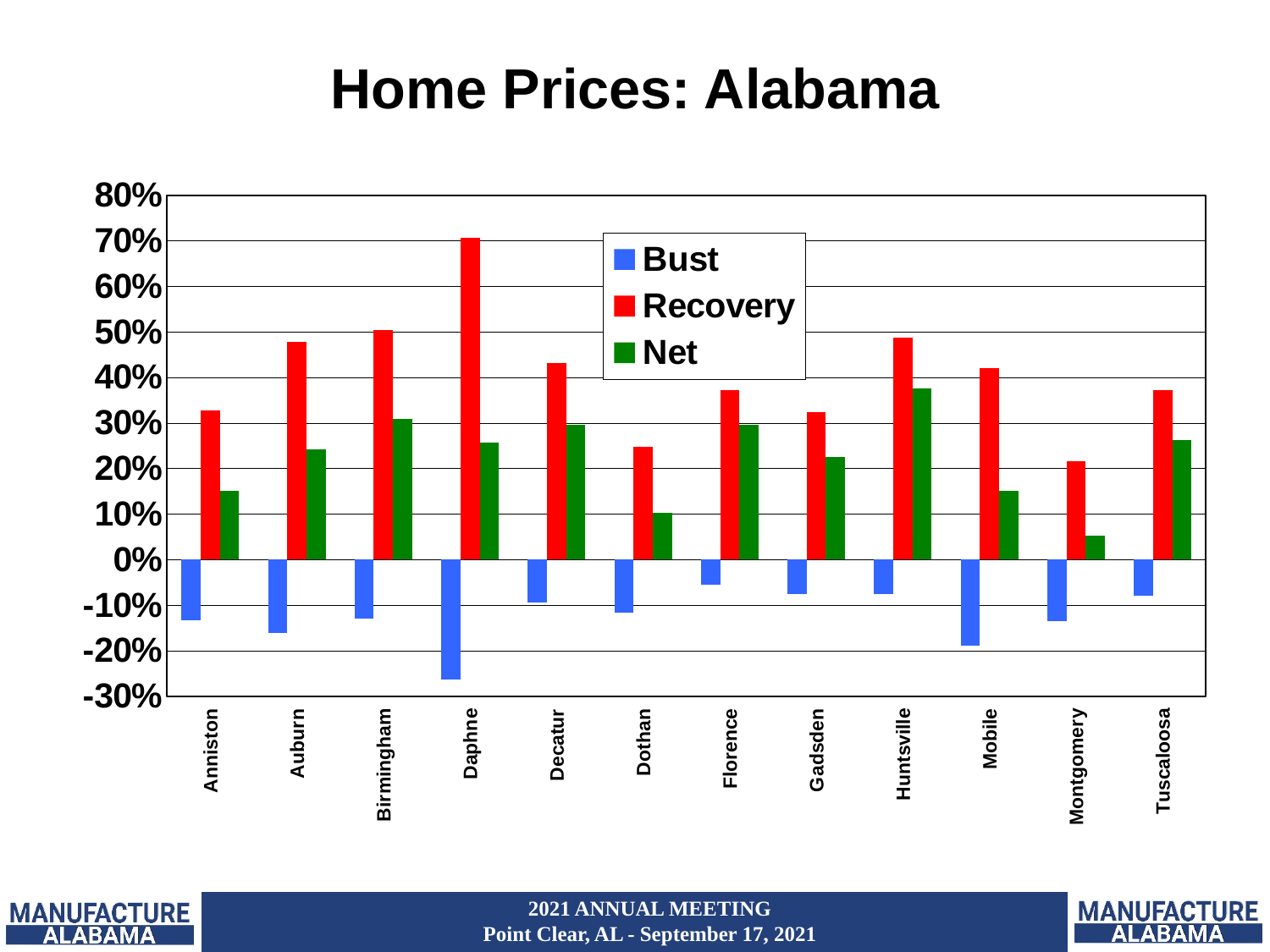
Is the Net value for Dothan greater or less than 20%? less What type of chart is shown on the slide? bar chart Is the Recovery value for Daphne greater or less than 60%? greater How many cities are shown on the x axis? 12 Which city has the highest Net value? Huntsville Which city has the highest Recovery value? Daphne What is the title of the chart? Home Prices: Alabama Which city has the lowest Recovery value? Montgomery Which city has the lowest Net value? Montgomery Which is larger, the Recovery value for Birmingham or the Recovery value for Dothan? Birmingham Which city has the most negative Bust value? Daphne How many series does the legend list? 3